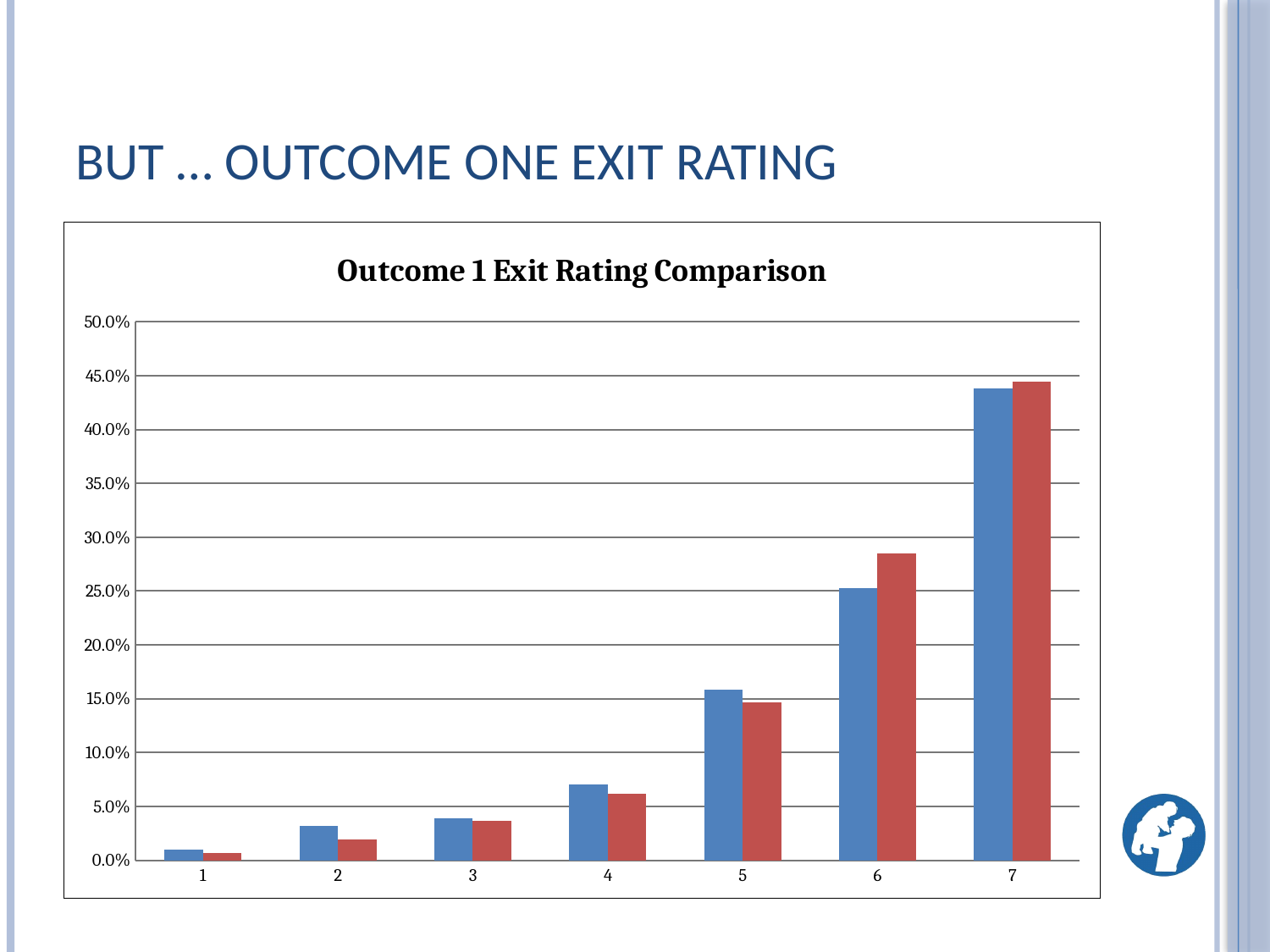
For category 6, which bar is larger, the blue bar or the red bar? red bar Is the value of the blue bar for category 4 greater or less than 10.0%? less Is the value of the blue bar for category 7 greater or less than 40.0%? greater How many categories are shown along the x axis of the chart? 7 Is the value of the red bar for category 6 greater or less than 25.0%? greater Which category has the lowest values on the chart? 1 Do the values generally rise or fall moving from category 1 to category 7? rise How many bars are plotted for each category on the chart? 2 What kind of chart is shown on the slide? bar chart What is the title of the chart? Outcome 1 Exit Rating Comparison Which category has the highest values on the chart? 7